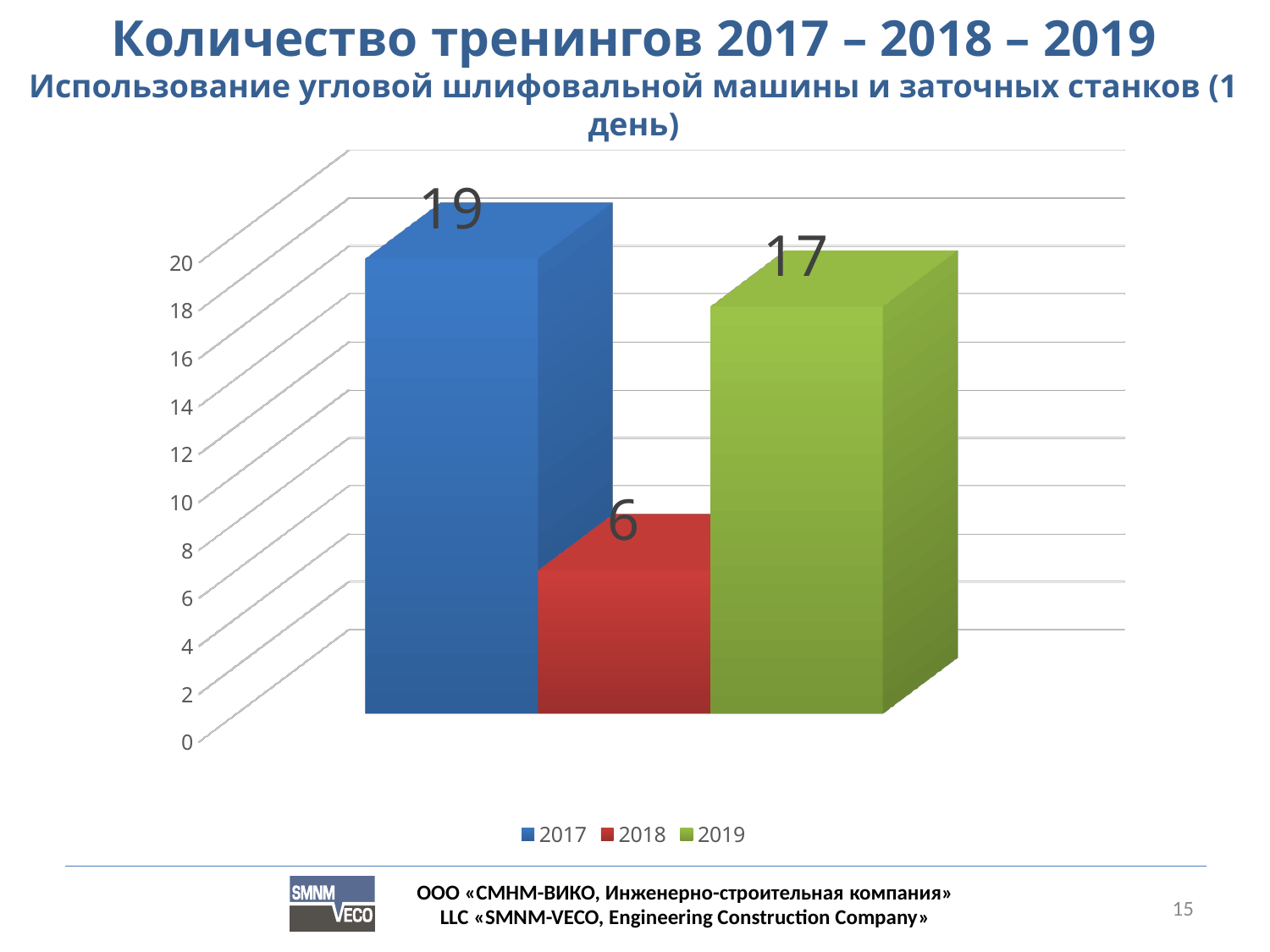
What kind of chart is shown on the slide? bar chart Which is larger, the value for 2018 or the value for 2019? 2019 What colour is the bar for 2019? green How many series does the legend list? 3 Which year has the lowest number of trainings? 2018 Is the value for 2018 greater or less than 10? less What is the value for 2019? 17 What is the value for 2017? 19 What is the difference between the values for 2017 and 2019? 2 Which year has the highest number of trainings? 2017 What is the value for 2018? 6 What is the difference between the values for 2017 and 2018? 13